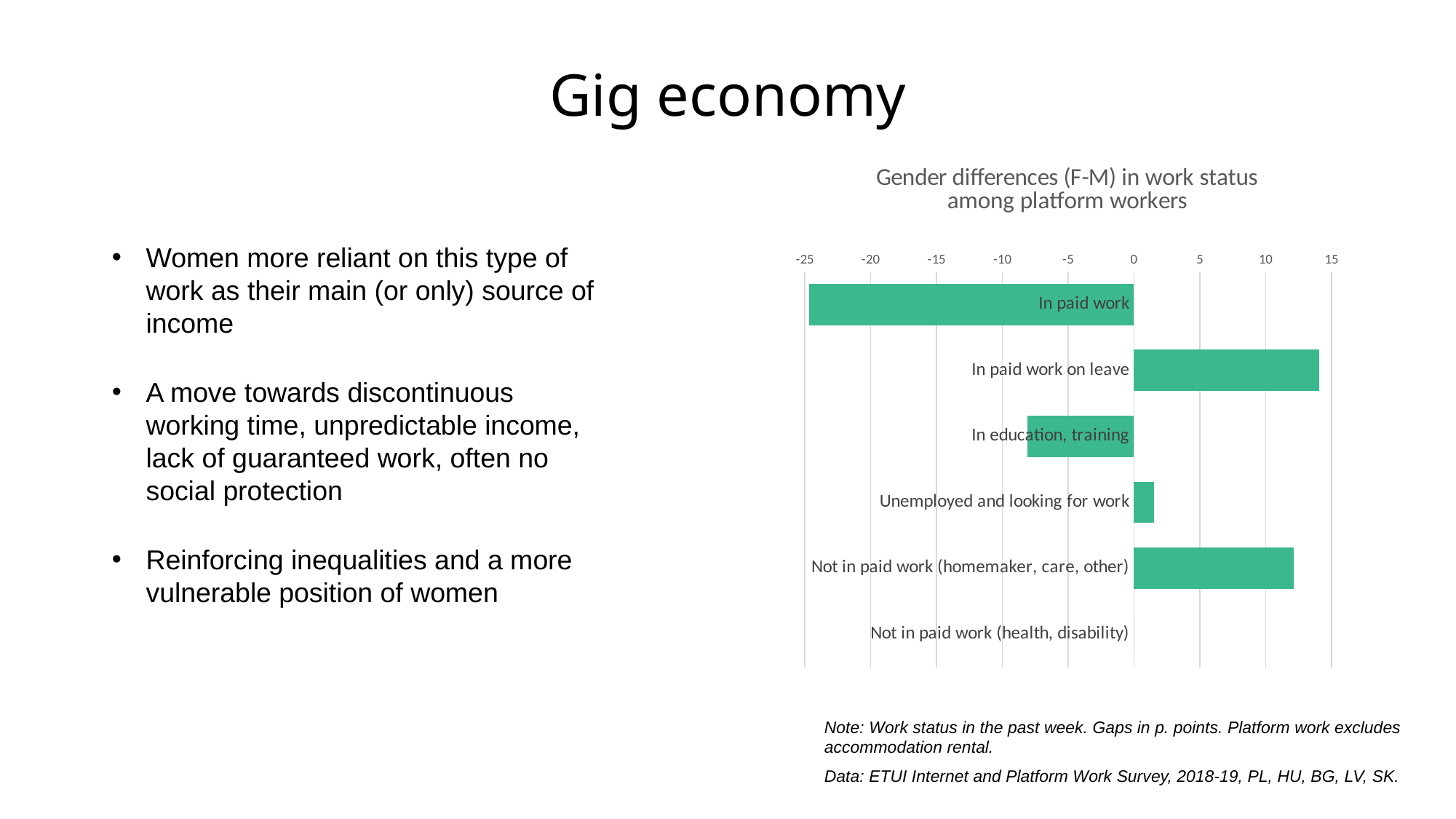
Is the value for In education, training greater or less than -5? less What kind of chart is shown on the slide? Bar chart Is the value for Not in paid work (homemaker, care, other) greater or less than 10? greater Which category has the highest value in the chart? In paid work on leave What are the minimum and maximum values shown on the chart's horizontal axis? -25 and 15 Is the value for In paid work on leave greater or less than 10? greater What is the title of the chart? Gender differences (F-M) in work status among platform workers How many work status categories are shown in the chart? 6 Which is larger, the value for Not in paid work (homemaker, care, other) or the value for Unemployed and looking for work? Not in paid work (homemaker, care, other) Which category has the lowest (most negative) value in the chart? In paid work